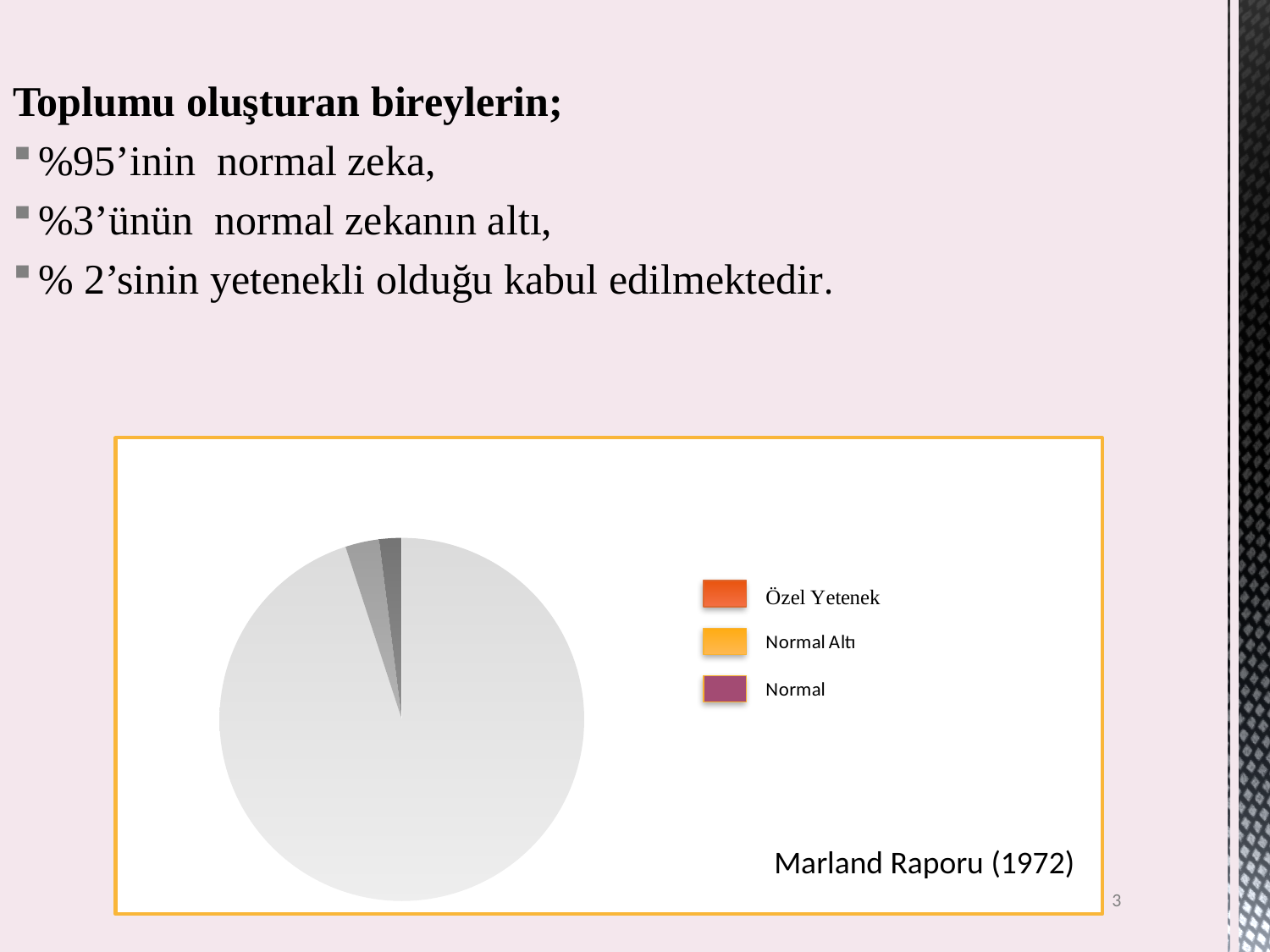
How many entries does the legend of the pie chart list? 3 Which category has the largest slice in the pie chart? Normal What kind of chart is shown on the slide? pie chart What are the three legend entries of the pie chart? Özel Yetenek, Normal Altı, Normal How many slices does the pie chart have? 3 What source caption is printed in the bottom right corner of the chart area? Marland Raporu (1972)